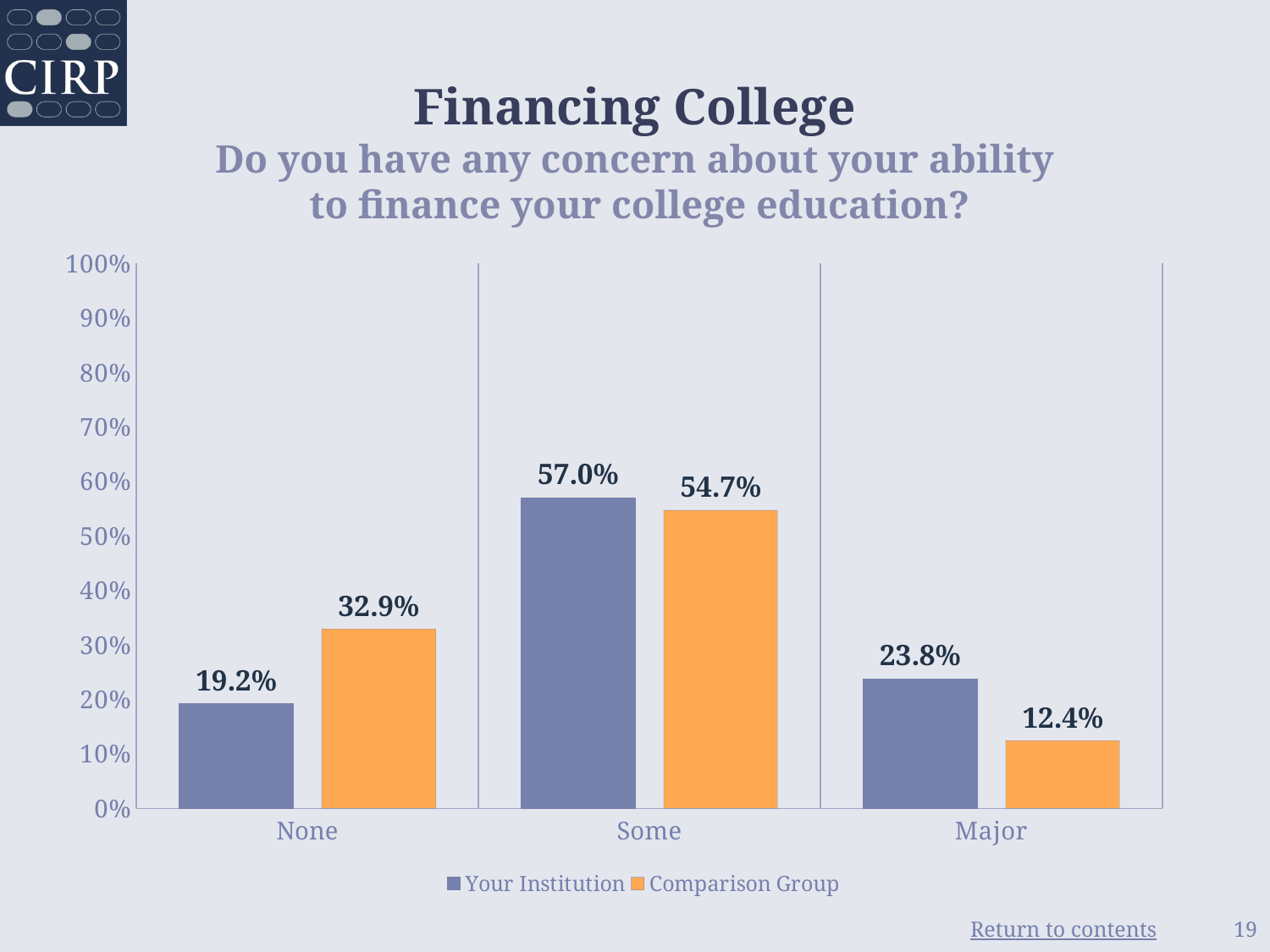
How many series does the legend list? 2 Which category has the highest value for Your Institution? Some How many categories are shown on the x axis? 3 What is the difference between Your Institution and Comparison Group in the Major category? 11.4% What is the value for Comparison Group in the Some category? 54.7% What is the value for Comparison Group in the Major category? 12.4% What is the difference between Comparison Group and Your Institution in the None category? 13.7% Which is larger in the Some category, Your Institution or Comparison Group? Your Institution What is the value for Your Institution in the None category? 19.2% Is the value for Comparison Group in the None category greater or less than 30%? greater Which category has the lowest value for Comparison Group? Major What kind of chart is shown on the slide? bar chart